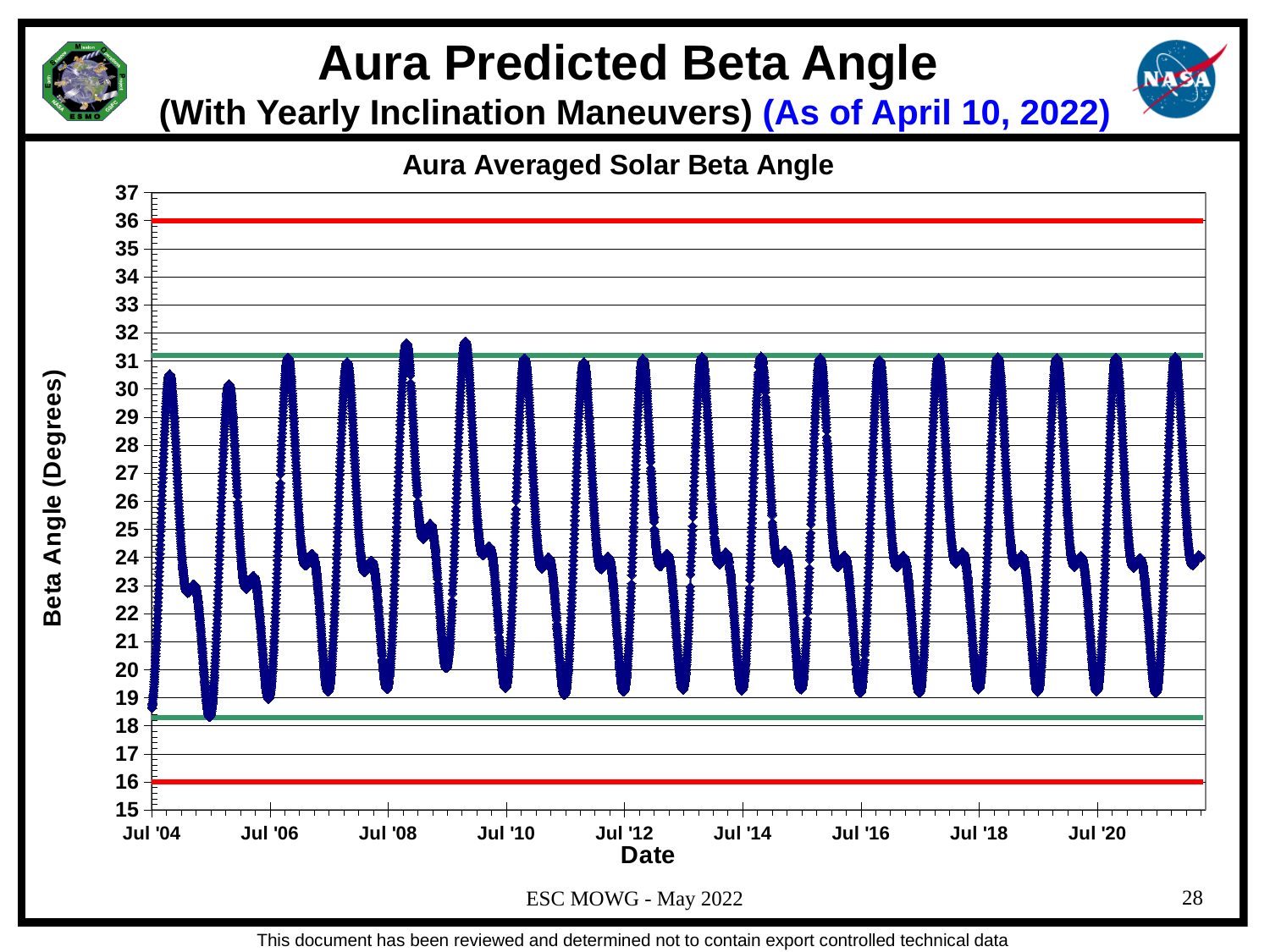
At what beta angle value is the lower red horizontal line drawn? 16 What is the highest value shown on the vertical axis of the chart? 37 What is the label of the vertical axis of the chart? Beta Angle (Degrees) What is the title of the chart on the slide? Aura Averaged Solar Beta Angle Is the peak of the blue series near Jul '20 greater or less than 29? greater Is the lowest trough of the blue series, shortly after Jul '04, greater or less than 19? less What is the lowest value shown on the vertical axis of the chart? 15 Does the blue series show a steady rise, a steady fall, or a repeated oscillation across the date axis? repeated oscillation At what beta angle value is the upper red horizontal line drawn? 36 How many date labels are printed along the horizontal axis? 9 What kind of chart is shown on the slide? line chart Is the highest peak of the blue series, near Jul '08, greater or less than 30? greater